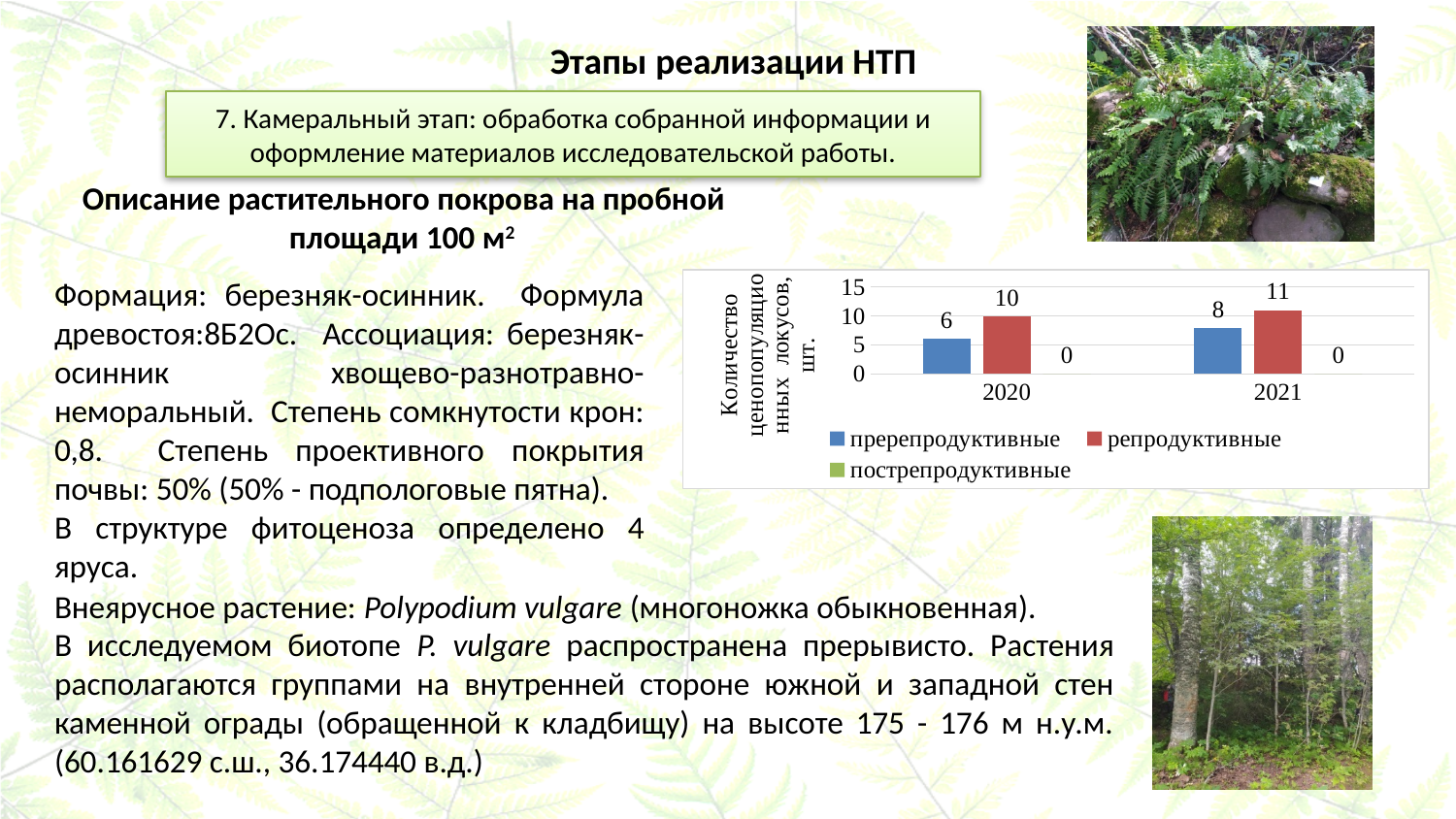
How many series does the chart legend list? 3 What is the value for пререпродуктивные in 2021? 8 What is the value for репродуктивные in 2021? 11 What is the difference between the репродуктивные values in 2021 and 2020? 1 Which series has the highest value in 2021? репродуктивные Which is larger: пререпродуктивные in 2020 or репродуктивные in 2020? репродуктивные in 2020 Which series has the lowest value in 2020? пострепродуктивные What is the value for пререпродуктивные in 2020? 6 Does the value for пререпродуктивные rise or fall from 2020 to 2021? rise What type of chart is shown on the slide? bar chart How many year categories are shown on the x axis of the chart? 2 What is the value for пострепродуктивные in 2020? 0